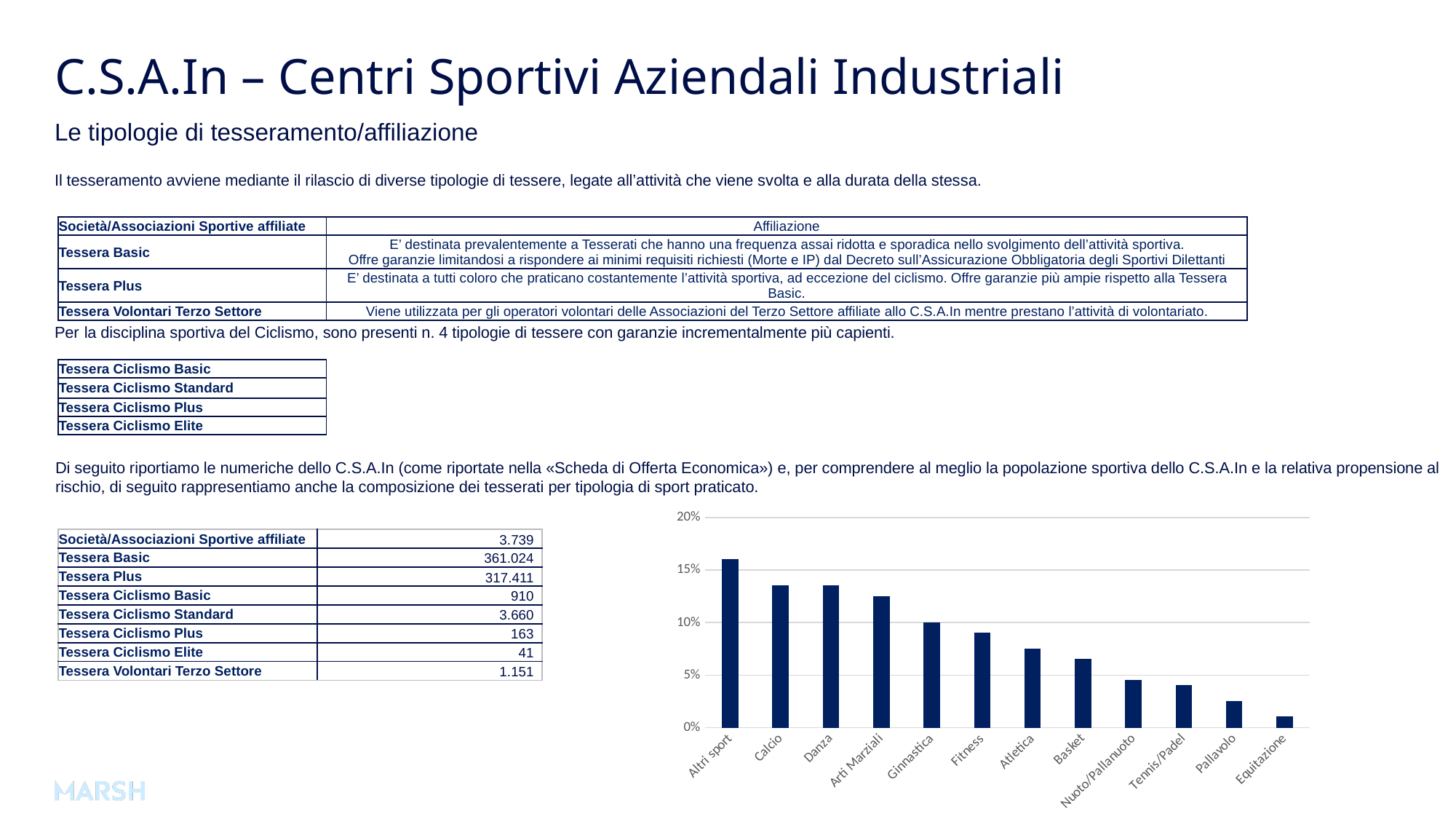
What kind of chart is shown on the slide? bar chart Which is larger, the value for Atletica or the value for Pallavolo? Atletica How many sport categories are shown on the x axis of the chart? 12 Which category has the highest bar in the chart? Altri sport Do the bar values rise or fall moving from left to right along the x axis? fall Which category has the lowest bar in the chart? Equitazione Is the value for Calcio greater or less than 15%? less Is the value for Fitness greater or less than 10%? less Is the value for Altri sport greater or less than 15%? greater What colour are the bars in the chart? dark blue